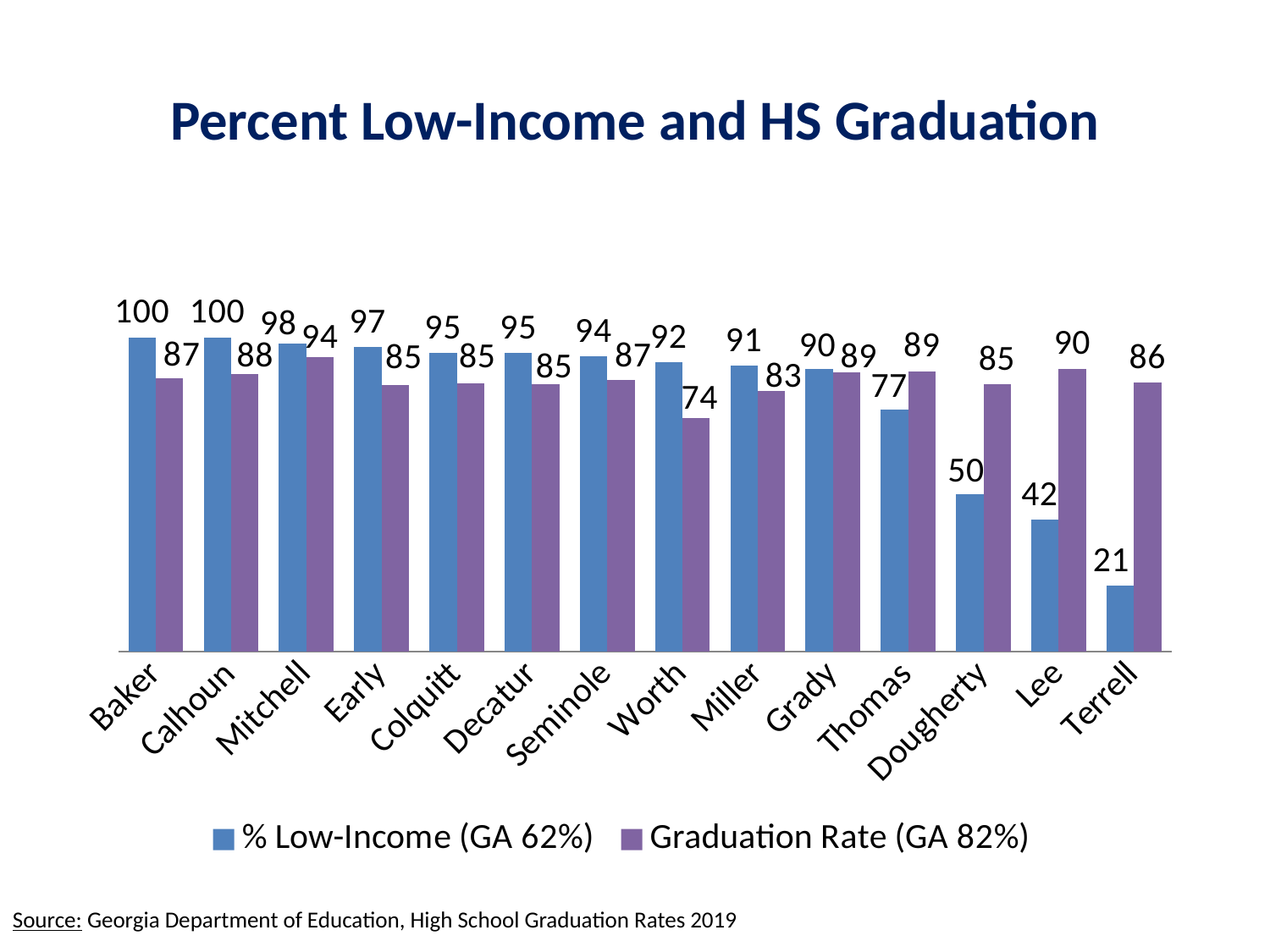
How many counties are shown on the x axis? 14 How many series does the legend list? 2 What is the title of the chart? Percent Low-Income and HS Graduation Do the % Low-Income values rise or fall from Baker to Terrell along the x axis? Fall What is the difference between the % Low-Income and Graduation Rate values for Terrell? 65 What kind of chart is shown on the slide? Bar chart Which county has the lowest Graduation Rate? Worth Which county has the lowest % Low-Income value? Terrell What is the Graduation Rate for Worth? 74 Which is larger for Dougherty: the % Low-Income value or the Graduation Rate? Graduation Rate What is the Graduation Rate for Lee? 90 What is the % Low-Income value for Thomas? 77